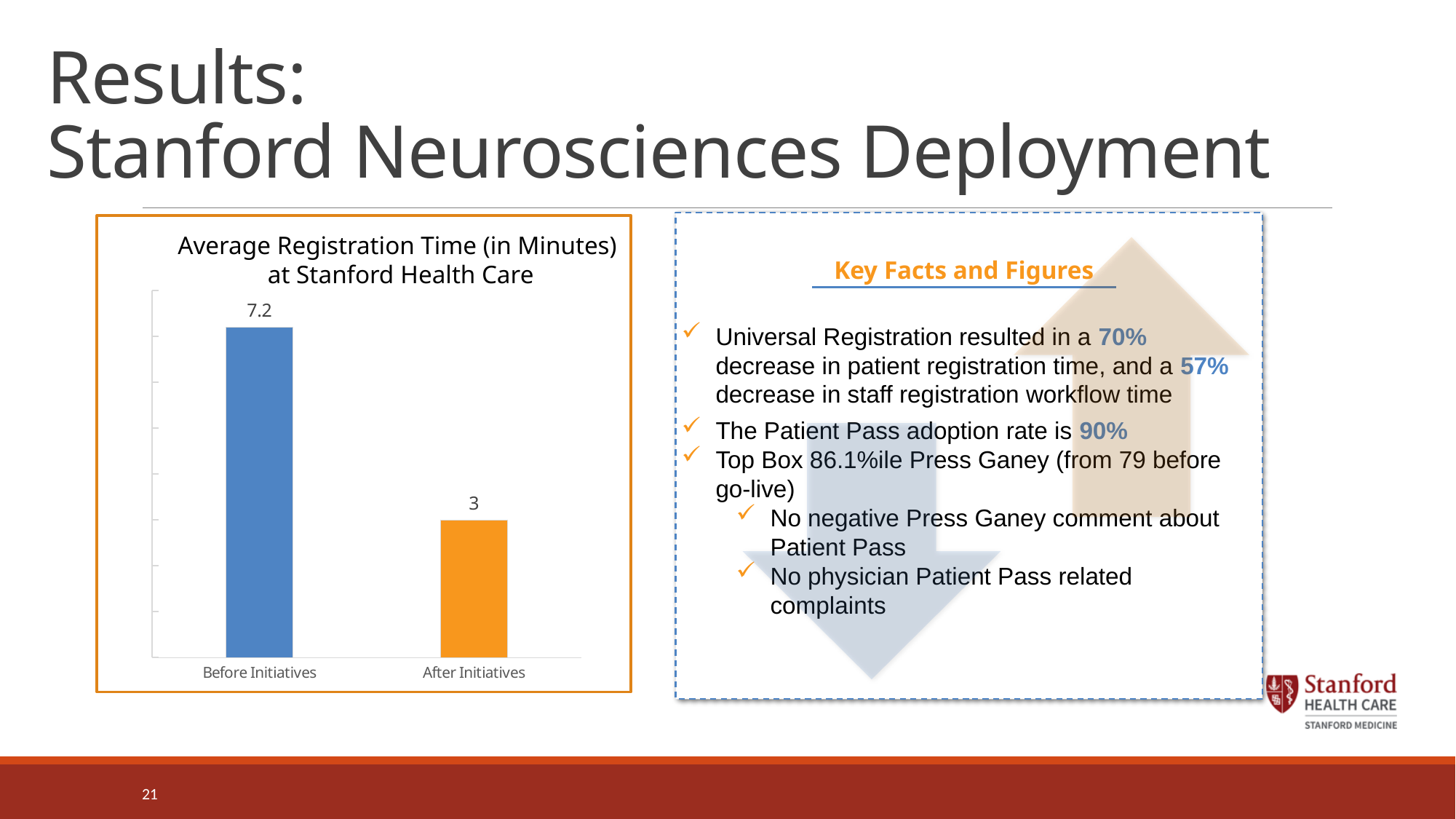
Which category has the highest average registration time? Before Initiatives What is the average registration time for After Initiatives? 3 What is the title of the chart? Average Registration Time (in Minutes) at Stanford Health Care How many categories are shown in the chart? 2 Which is larger, the value for Before Initiatives or After Initiatives? Before Initiatives What is the average registration time for Before Initiatives? 7.2 Which category has the lowest average registration time? After Initiatives What kind of chart is shown on the slide? Bar chart What is the difference in average registration time between Before Initiatives and After Initiatives? 4.2 Do the values rise or fall from Before Initiatives to After Initiatives? Fall What colour is the bar for After Initiatives? Orange